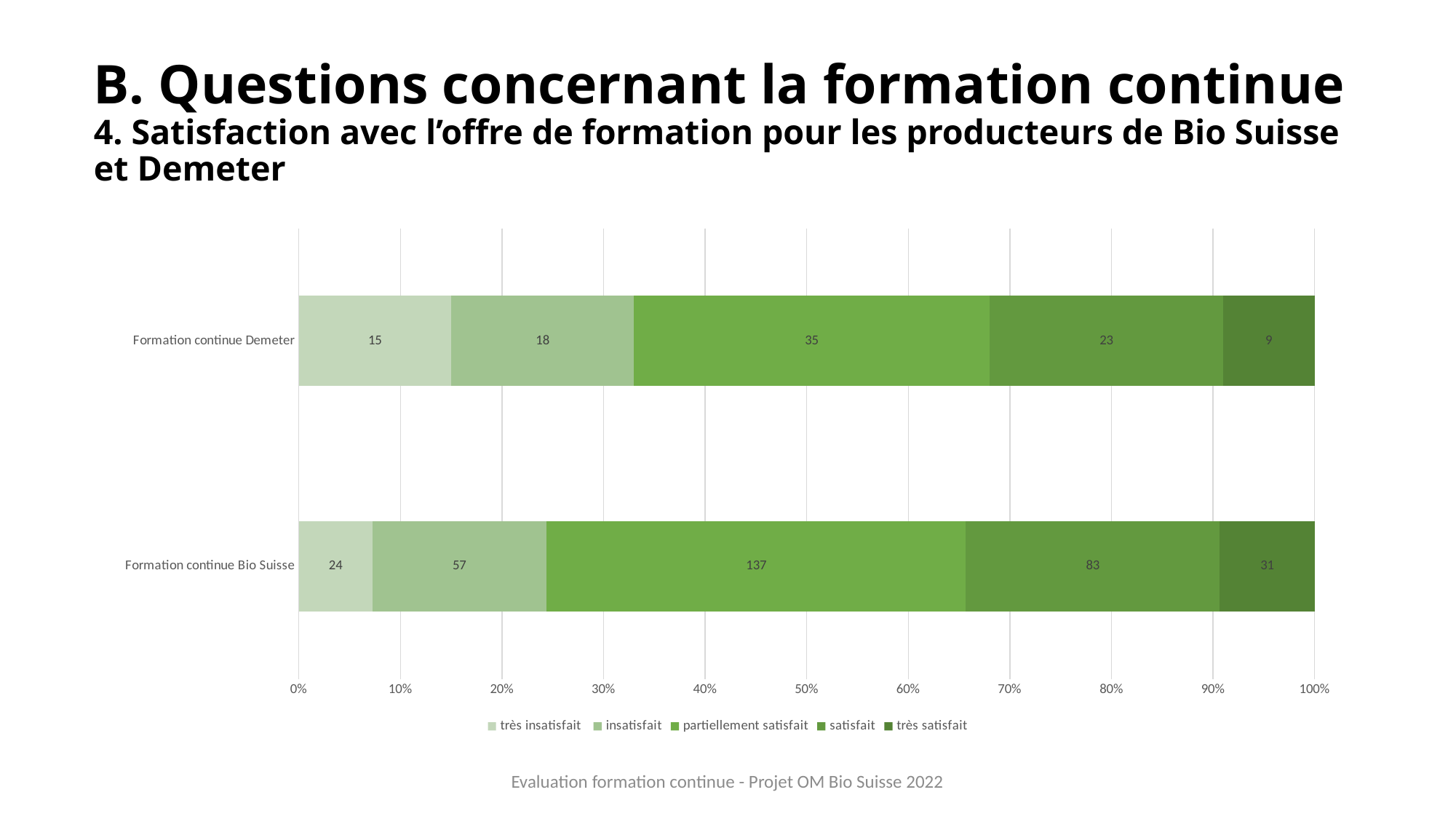
Which is larger: 'très insatisfait' for Formation continue Bio Suisse or 'insatisfait' for Formation continue Demeter? très insatisfait for Formation continue Bio Suisse What is the value for 'insatisfait' in the Formation continue Bio Suisse bar? 57 What kind of chart is shown on the slide? Stacked bar chart How many series does the legend list? 5 What is the total of all segments in the Formation continue Bio Suisse bar? 332 Which segment has the lowest value in the Formation continue Bio Suisse bar? très insatisfait Which segment has the highest value in the Formation continue Demeter bar? partiellement satisfait What is the first entry listed in the chart legend? très insatisfait How many categories (bars) are plotted in the chart? 2 What is the difference between the 'satisfait' values for Formation continue Bio Suisse and Formation continue Demeter? 60 What is the value for 'partiellement satisfait' in the Formation continue Bio Suisse bar? 137 What is the value for 'très satisfait' in the Formation continue Demeter bar? 9